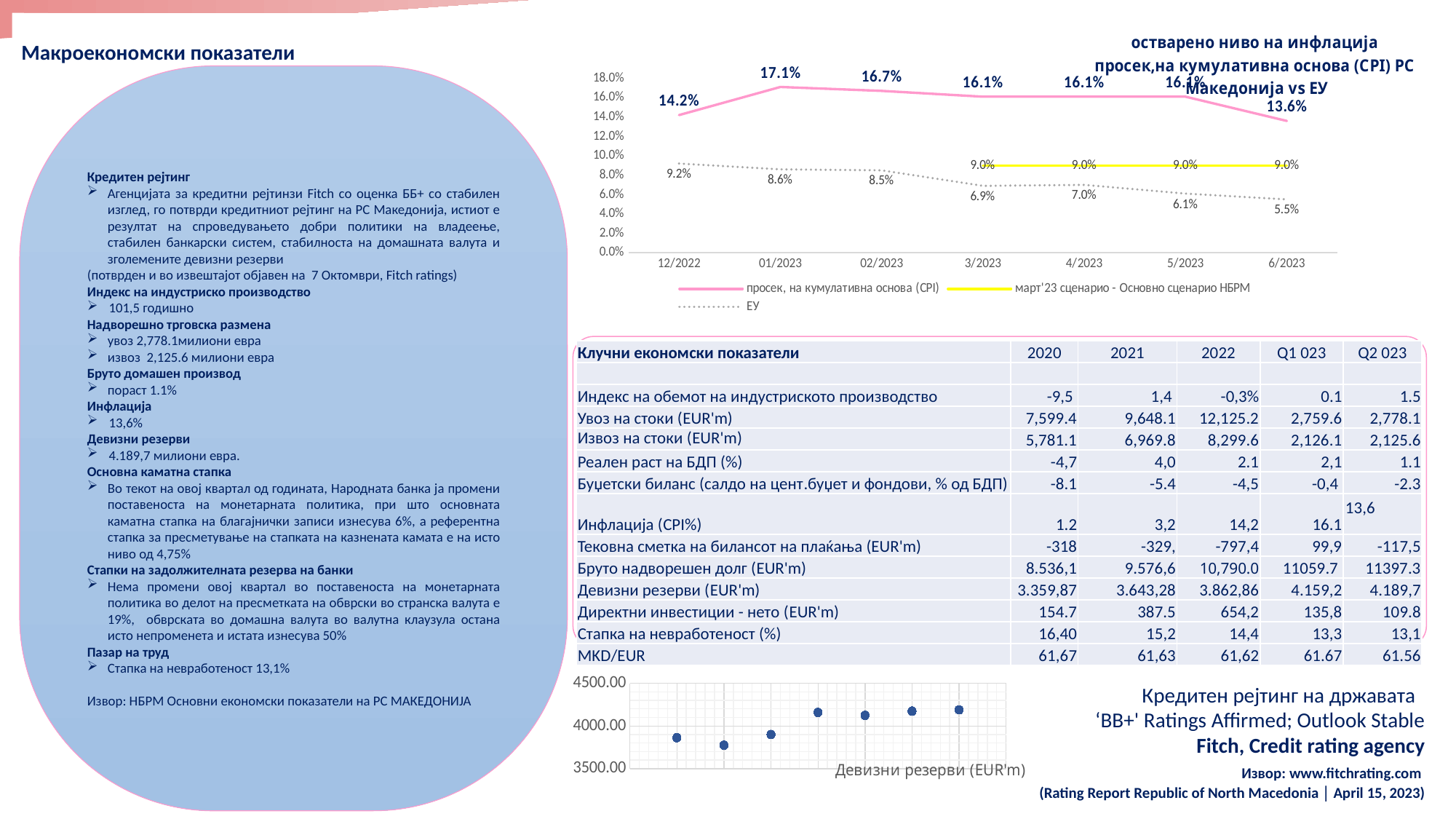
In the top-right inflation chart, does the 'ЕУ' series generally rise or fall from 12/2022 to 6/2023? fall In the top-right inflation chart, how many series does the legend list? 3 In the top-right inflation chart, which series has the larger value at 12/2022: 'просек, на кумулативна основа (CPI)' or 'ЕУ'? просек, на кумулативна основа (CPI) What kind of chart is the 'Девизни резерви (EUR'm)' chart at the bottom of the slide? scatter chart In the top-right inflation chart, at which month is the 'ЕУ' series lowest? 6/2023 In the top-right inflation chart, what is the difference between the 'просек, на кумулативна основа (CPI)' value and the 'ЕУ' value at 6/2023? 8.1 percentage points In the top-right inflation chart, what is the value of the 'ЕУ' series at 6/2023? 5.5% In the top-right inflation chart, what is the value of the 'просек, на кумулативна основа (CPI)' series at 01/2023? 17.1% In the top-right inflation chart, at which month does the 'просек, на кумулативна основа (CPI)' series reach its highest value? 01/2023 In the top-right inflation chart, what value does the 'март'23 сценарио - Основно сценарио НБРМ' series show at 4/2023? 9.0% In the bottom 'Девизни резерви (EUR'm)' chart, is the value of the first point greater or less than 4000.00? less In the top-right inflation chart, how many months are shown on the x axis? 7